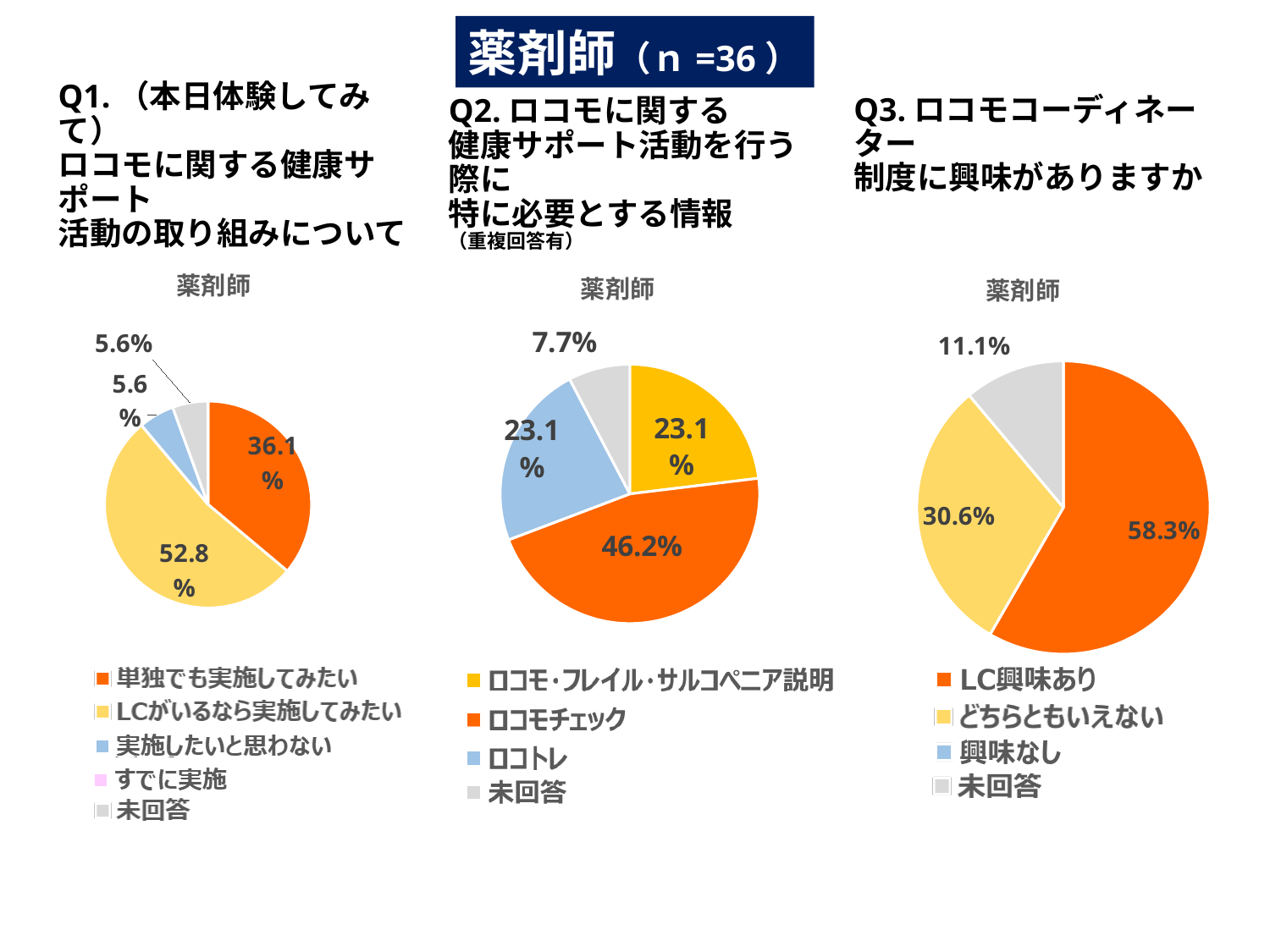
On the right pie chart (Q3), what percentage is shown for LC興味あり? 58.3% On the middle pie chart (Q2), what percentage is shown for ロコモチェック? 46.2% On the left pie chart (Q1), which category has the largest slice? LCがいるなら実施してみたい On the middle pie chart (Q2), what is the difference between ロコモチェック and ロコトレ? 23.1% On the middle pie chart (Q2), which category has the smallest slice? 未回答 What type of chart is used for the three charts on the slide? Pie chart On the left pie chart (Q1), what percentage is shown for LCがいるなら実施してみたい? 52.8% On the right pie chart (Q3), what percentage is shown for どちらともいえない? 30.6% On the middle pie chart (Q2), what percentage is shown for 未回答? 7.7% On the left pie chart (Q1), what percentage is shown for 単独でも実施してみたい? 36.1% On the left pie chart (Q1), how many entries does the legend list? 5 On the right pie chart (Q3), which is larger, LC興味あり or どちらともいえない? LC興味あり